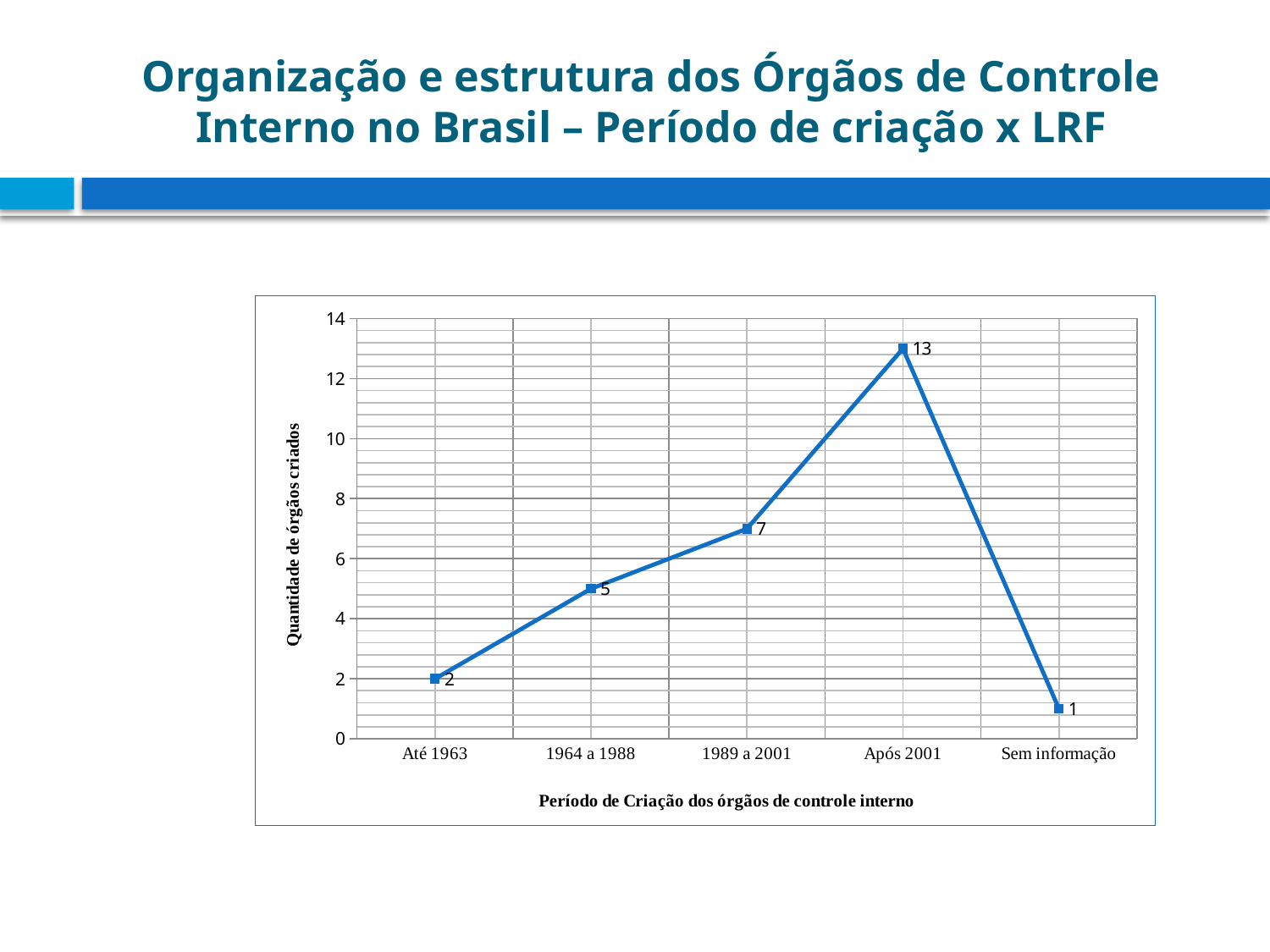
What is the difference between the values for "Após 2001" and "1989 a 2001"? 6 What kind of chart is this? Line chart What is the value for "Após 2001"? 13 What is the value for "Sem informação"? 1 What is the value for "Até 1963"? 2 Which category has the lowest value? Sem informação How many categories are shown on the x axis? 5 Do the values rise or fall from "Até 1963" to "Após 2001"? Rise Which is larger, the value for "1964 a 1988" or the value for "1989 a 2001"? 1989 a 2001 Which category has the highest value? Após 2001 What is the value for "1964 a 1988"? 5 What is the label of the y axis? Quantidade de órgãos criados